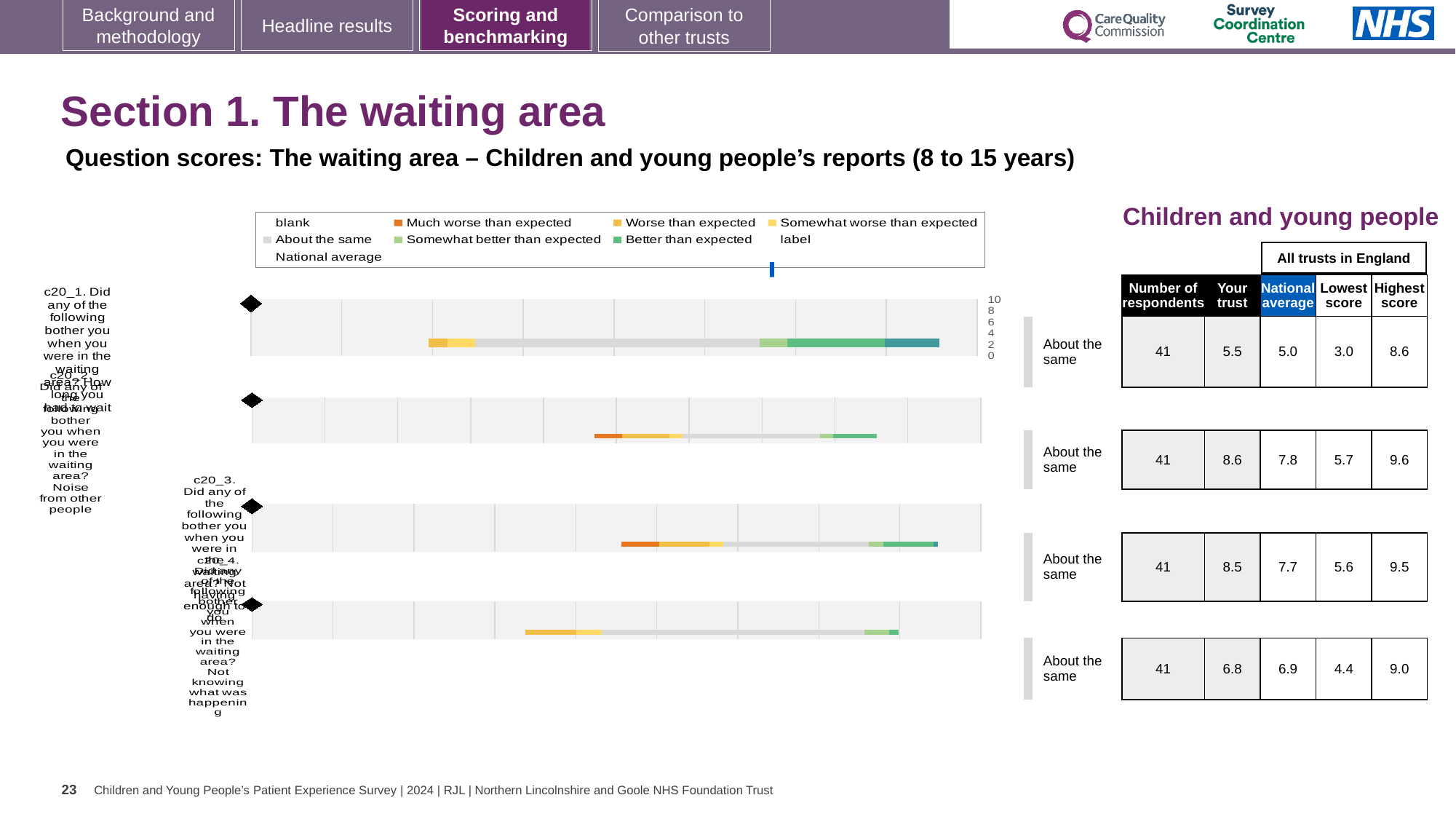
How many question bars are plotted in the chart? 4 What kind of chart is shown on the slide? bar chart Which question row has the lowest 'Your trust' score in the table? c20_1 (noise from other people), 5.5 What colour does the legend use for 'Much worse than expected'? Orange For the fourth question row (c20_4), which is larger: the 'Your trust' score or the national average? National average (6.9) In the table, what is the highest score for the third question row (c20_3, not having enough to do)? 9.5 How many respondents are listed for each question in the table? 41 What is the difference between the 'Your trust' score and the national average for the second question row (c20_2)? 0.8 Which question row has the highest 'Your trust' score in the table? c20_2 (how long you had to wait), 8.6 In the table, what is the lowest score for the fourth question row (c20_4, not knowing what was happening)? 4.4 In the table, what is the 'Your trust' score for the first question row (c20_1, noise from other people)? 5.5 In the table, what is the national average for the second question row (c20_2, how long you had to wait)? 7.8